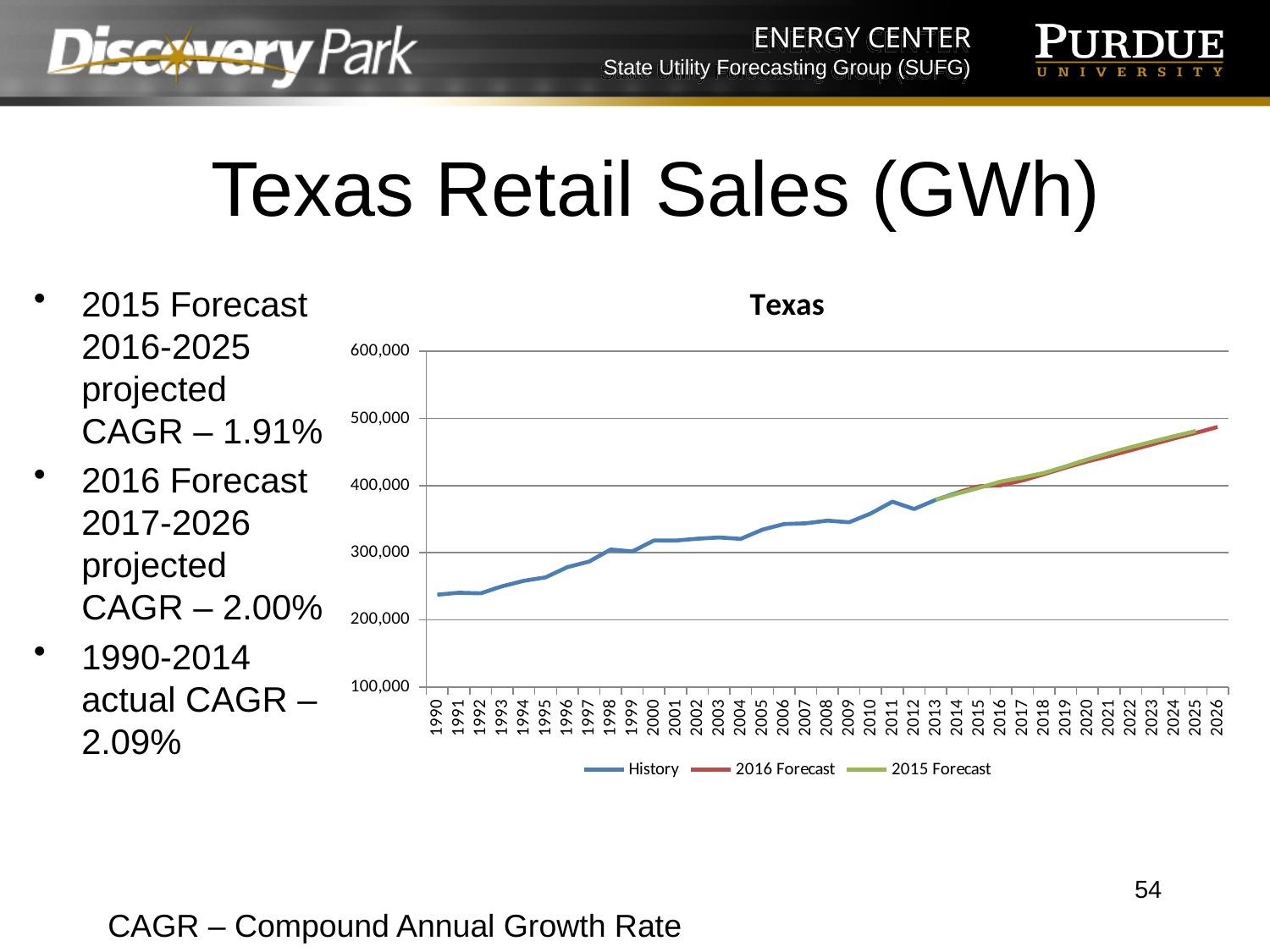
Is the History value for 1990 in the Texas chart greater or less than 200,000? greater What is the title printed above the chart? Texas Is the History value for 1990 in the Texas chart greater or less than 300,000? less Do the History values in the Texas chart generally rise or fall from 1990 to 2014? rise What kind of chart is shown on the slide? line chart Is the 2016 Forecast value for 2020 in the Texas chart greater or less than 400,000? greater How many years are labelled along the x axis of the Texas chart? 37 How many series does the legend of the Texas chart list? 3 In the Texas chart, which is larger: the History value for 1990 or the History value for 2014? 2014 What are the series names listed in the legend of the Texas chart? History, 2016 Forecast, 2015 Forecast